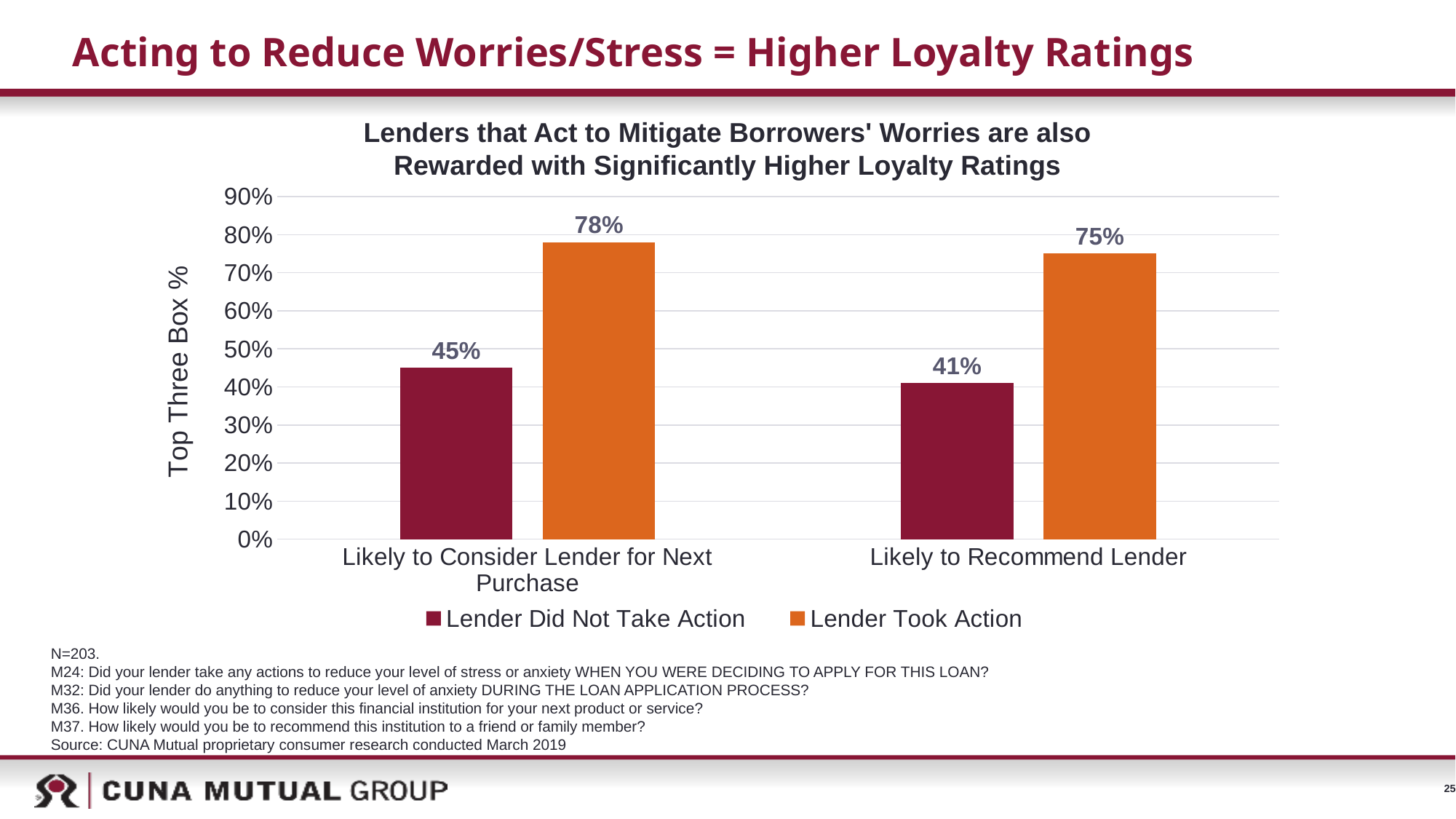
What is the value for Lender Took Action in the Likely to Recommend Lender category? 75% What is the difference between Lender Took Action and Lender Did Not Take Action for Likely to Recommend Lender? 34% How many categories are shown on the x axis? 2 What is the value for Lender Did Not Take Action in the Likely to Consider Lender for Next Purchase category? 45% For Likely to Recommend Lender, which series has the larger value: Lender Did Not Take Action or Lender Took Action? Lender Took Action What is the difference between Lender Took Action and Lender Did Not Take Action for Likely to Consider Lender for Next Purchase? 33% Which bar has the lowest value on the chart? Lender Did Not Take Action, Likely to Recommend Lender What is the value for Lender Did Not Take Action in the Likely to Recommend Lender category? 41% What kind of chart is shown on the slide? Bar chart How many series does the legend list? 2 What is the value for Lender Took Action in the Likely to Consider Lender for Next Purchase category? 78% Which bar has the highest value on the chart? Lender Took Action, Likely to Consider Lender for Next Purchase